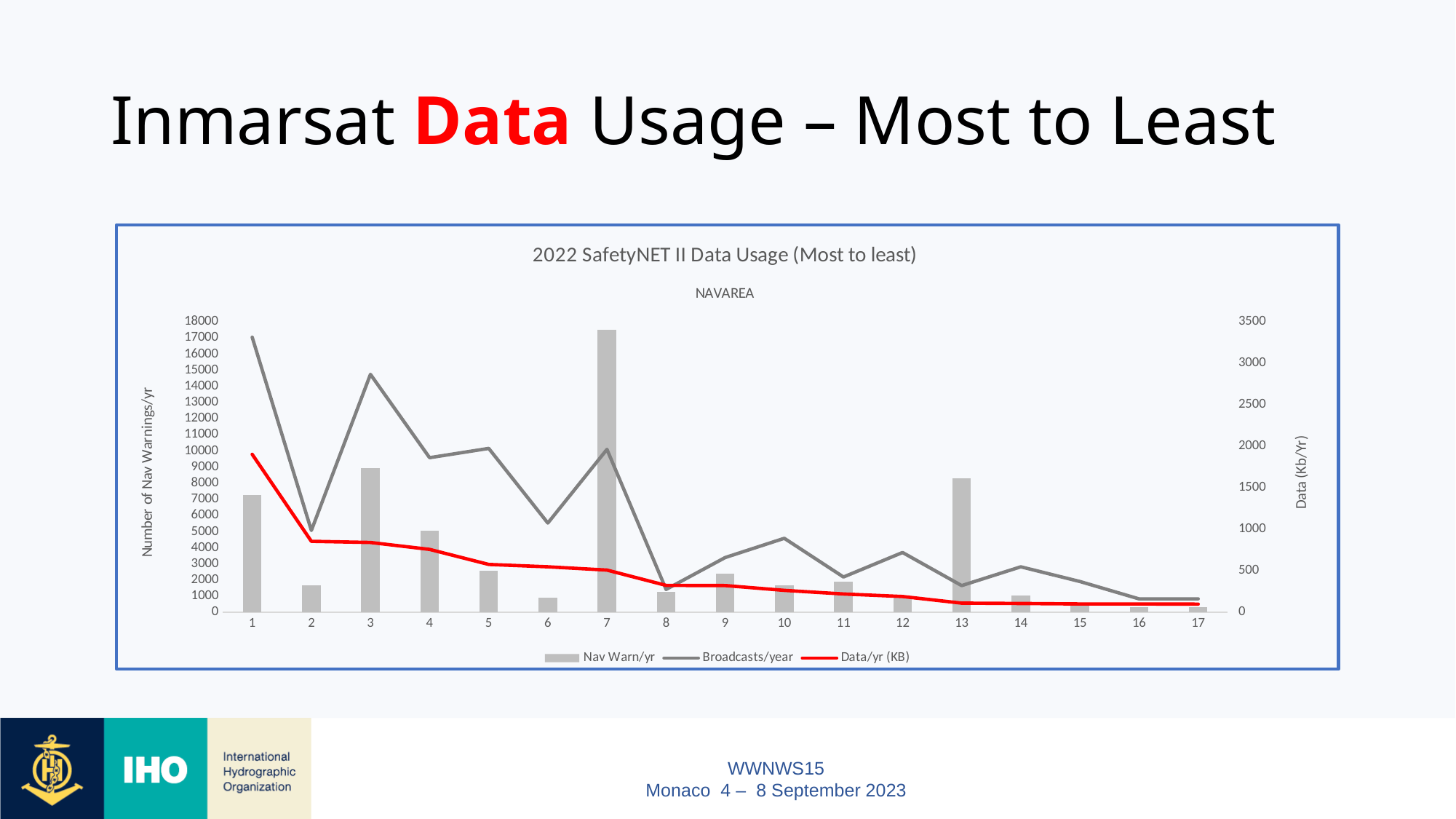
What kind of chart is this? Combination bar and line chart What is the label of the left vertical axis? Number of Nav Warnings/yr How many series does the chart legend list? 3 Which NAVAREA has the highest Broadcasts/year value? 1 What is the title of the chart? 2022 SafetyNET II Data Usage (Most to least) Which NAVAREA has the highest Nav Warn/yr bar? 7 Which has the larger Nav Warn/yr value, NAVAREA 7 or NAVAREA 13? NAVAREA 7 How many NAVAREA categories are shown on the x axis? 17 Is the Broadcasts/year value for NAVAREA 2 greater or less than 10000? less Does the Data/yr (KB) line generally rise or fall from NAVAREA 1 to NAVAREA 17? Fall